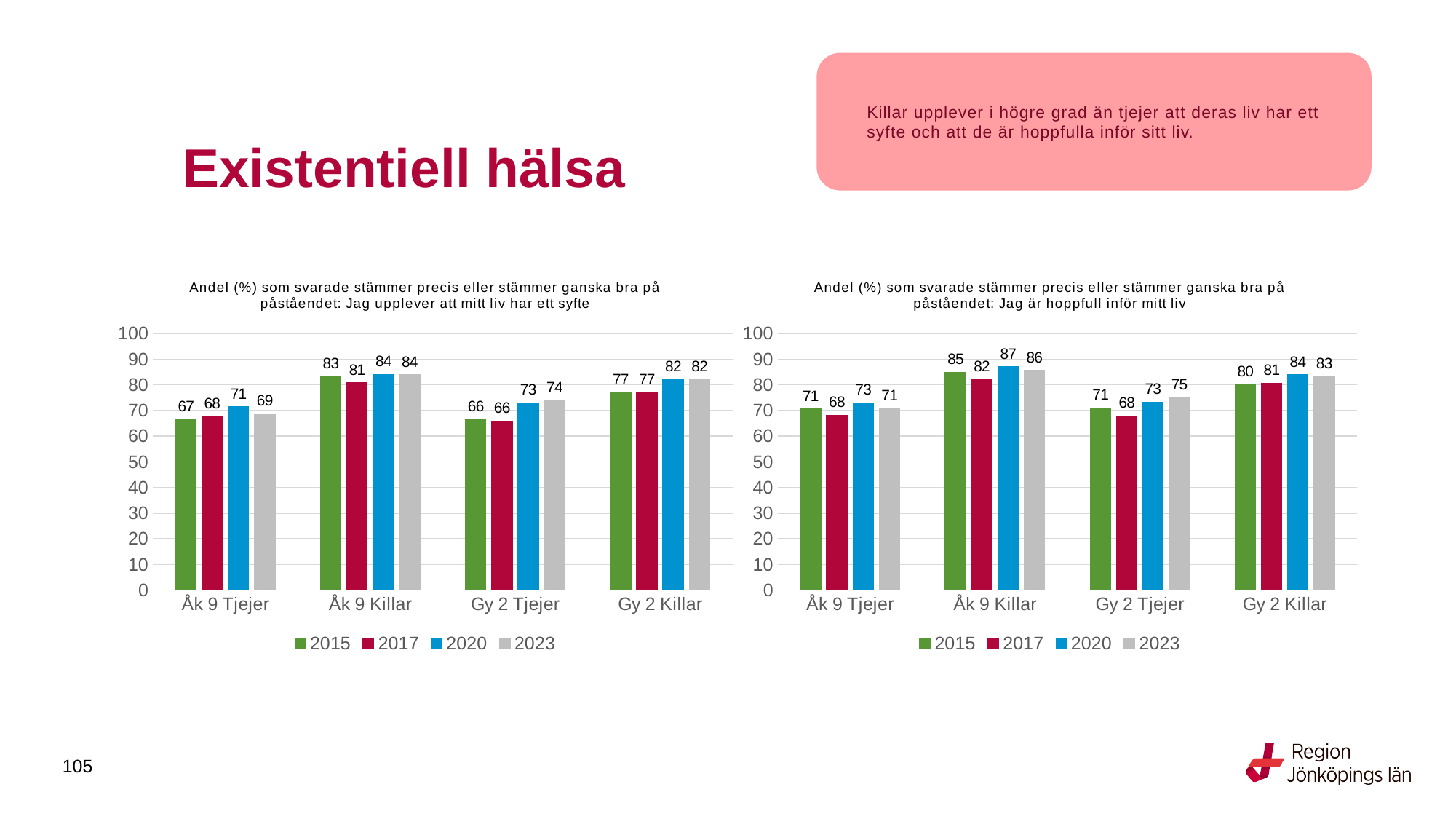
In the right chart (Jag är hoppfull inför mitt liv), what is the value for Gy 2 Tjejer in 2017? 68 What kind of chart is the left chart (Jag upplever att mitt liv har ett syfte)? Bar chart In the right chart (Jag är hoppfull inför mitt liv), is the value for Gy 2 Killar in 2020 greater or less than 80? greater In the left chart (Jag upplever att mitt liv har ett syfte), which is larger for Gy 2 Tjejer: the 2015 value or the 2023 value? 2023 How many series does the legend of the right chart (Jag är hoppfull inför mitt liv) list? 4 In the right chart (Jag är hoppfull inför mitt liv), what is the difference between Åk 9 Killar and Åk 9 Tjejer in 2015? 14 In the left chart (Jag upplever att mitt liv har ett syfte), which category has the lowest value in 2023? Åk 9 Tjejer In the left chart (Jag upplever att mitt liv har ett syfte), what is the value for Åk 9 Killar in 2020? 84 In the left chart (Jag upplever att mitt liv har ett syfte), what is the difference between Gy 2 Killar and Gy 2 Tjejer in 2023? 8 In the left chart (Jag upplever att mitt liv har ett syfte), do the values for Gy 2 Tjejer rise or fall from 2017 to 2023? Rise In the right chart (Jag är hoppfull inför mitt liv), which category has the highest value in 2020? Åk 9 Killar How many categories are shown on the x axis of the left chart (Jag upplever att mitt liv har ett syfte)? 4